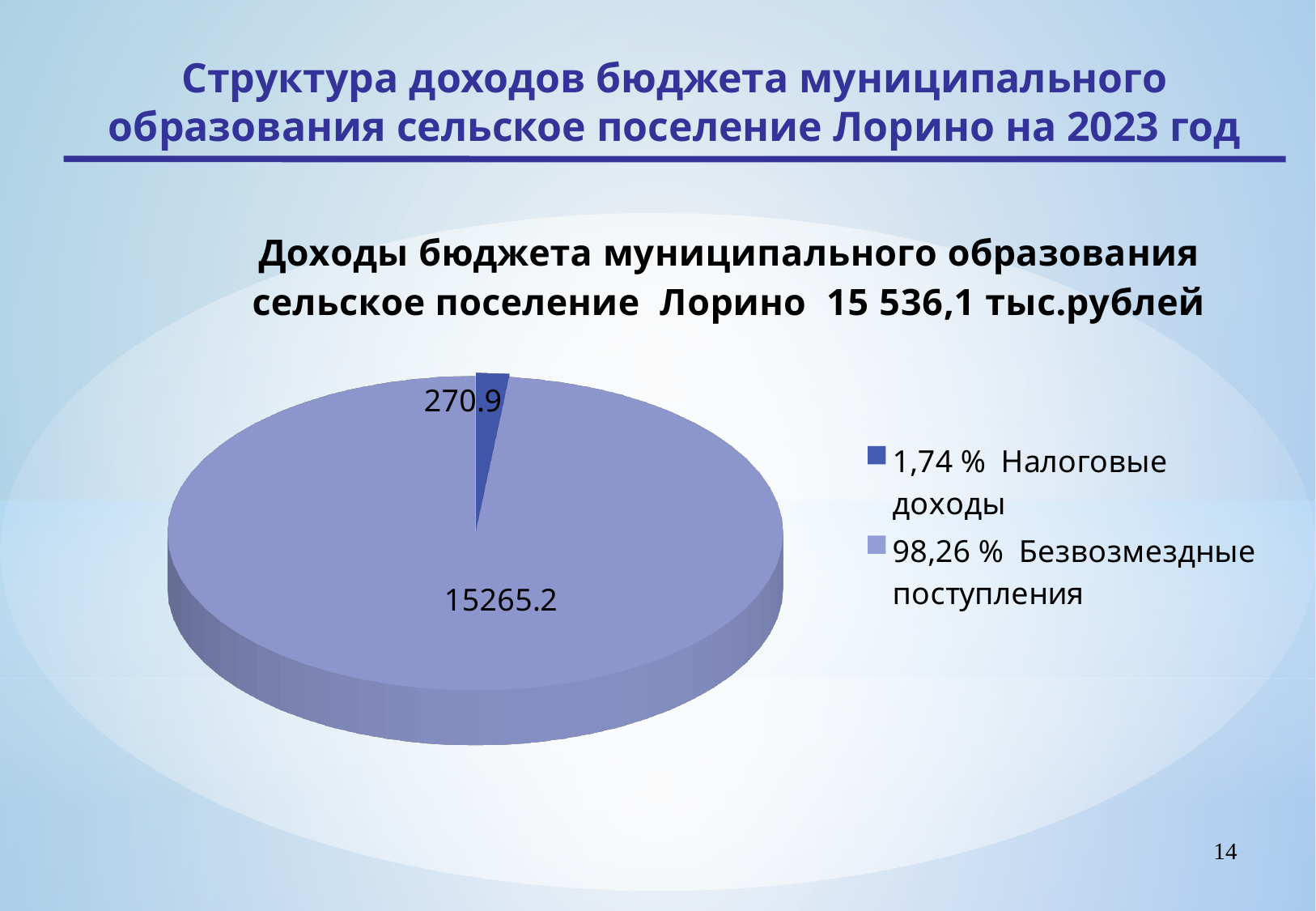
What is the value for Налоговые доходы? 270.9 What share of the pie does Безвозмездные поступления represent, according to the legend? 98,26 % How many slices does the pie chart have? 2 What is the difference between the values for Безвозмездные поступления and Налоговые доходы? 14994.3 Which category has the largest slice of the pie? Безвозмездные поступления What is the value for Безвозмездные поступления? 15265.2 What kind of chart is shown on the slide? pie chart Which category has the smallest slice of the pie? Налоговые доходы What share of the pie does Налоговые доходы represent, according to the legend? 1,74 % How many entries does the legend list? 2 What total amount of budget revenue is stated in the chart title? 15 536,1 тыс.рублей Which is larger, Налоговые доходы or Безвозмездные поступления? Безвозмездные поступления